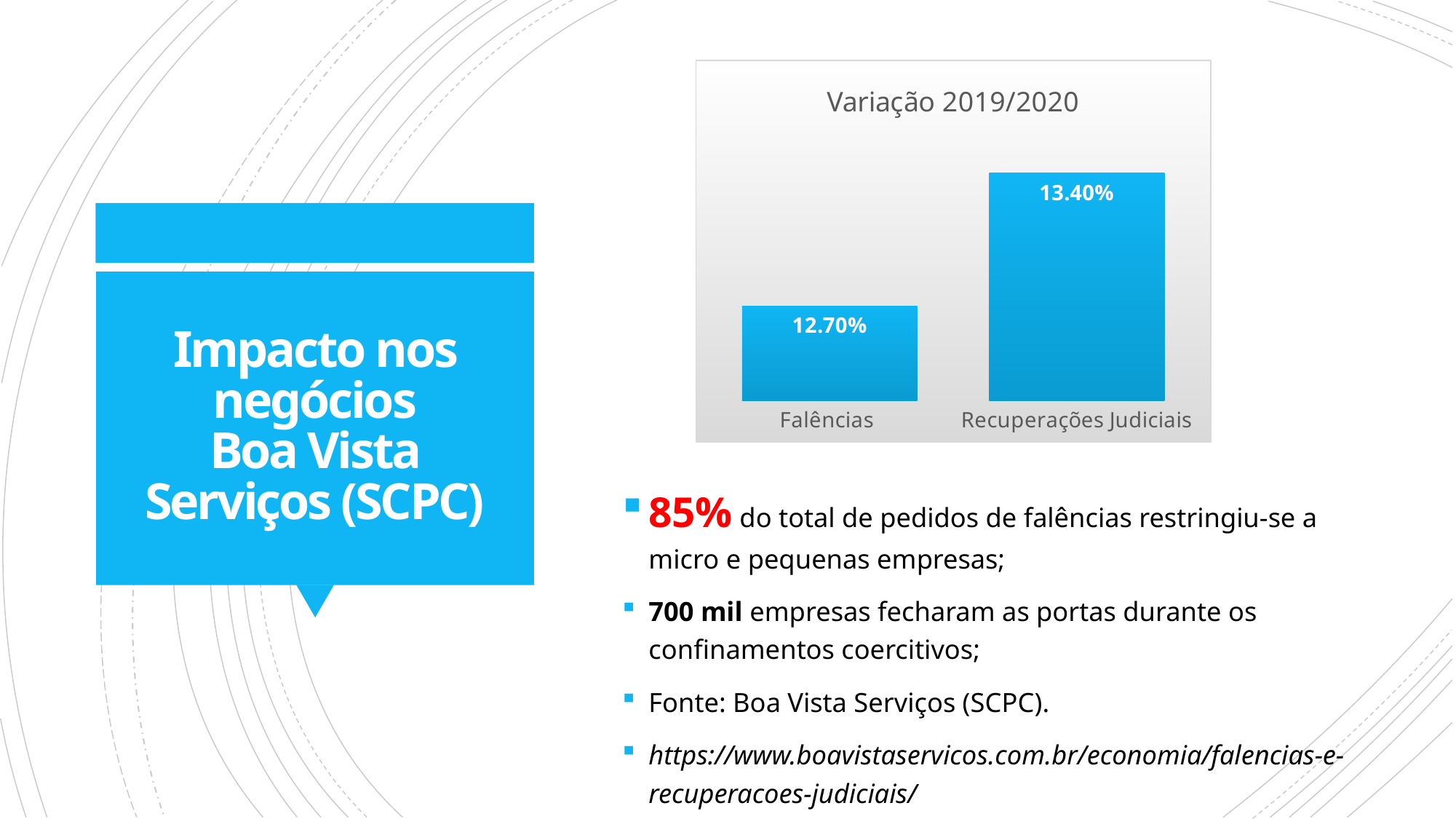
What is the title of the chart? Variação 2019/2020 What is the value for Recuperações Judiciais? 13.40% Which is larger, the value for Falências or the value for Recuperações Judiciais? Recuperações Judiciais Do the values rise or fall from Falências to Recuperações Judiciais? Rise What kind of chart is shown on the slide? Bar chart How many categories are shown in the chart? 2 What is the value for Falências? 12.70% What is the difference between the values for Recuperações Judiciais and Falências? 0.70% Which category has the lowest value? Falências Which category has the highest value? Recuperações Judiciais